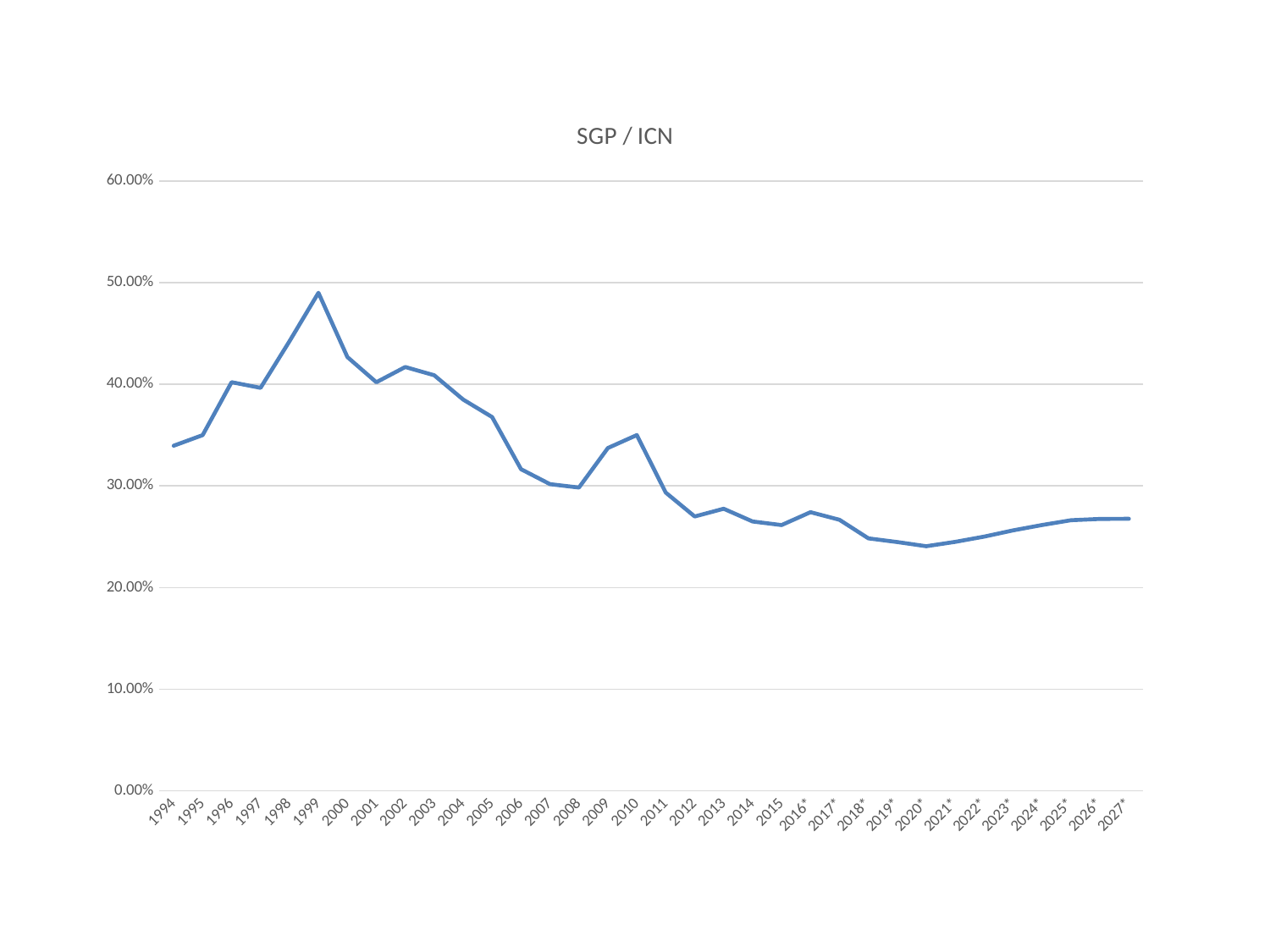
Which is larger, the value for 2010 or the value for 2020*? 2010 Is the value for 1999 greater or less than 40.00%? greater Overall, do the values rise or fall from 1994 to 2027*? fall Is the value for 2010 greater or less than 30.00%? greater Is the value for 2005 greater or less than 30.00%? greater What is the title of the chart? SGP / ICN How many years are plotted along the x axis? 34 What kind of chart is shown on the slide? line chart Which year has the highest value on the chart? 1999 Which is larger, the value for 1999 or the value for 2010? 1999